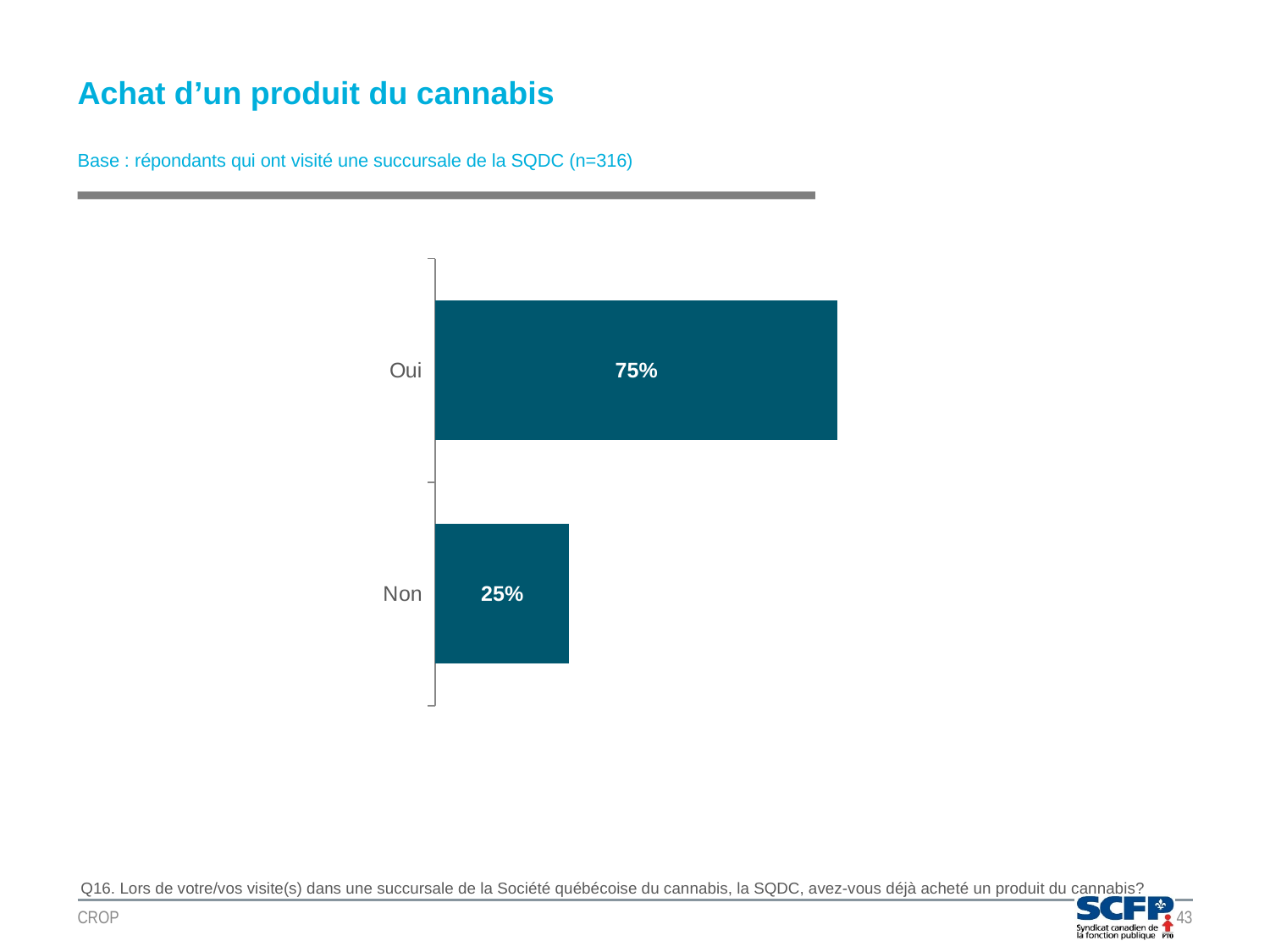
Which category has the lowest value? Non What is the difference between the values for Oui and Non? 50% What kind of chart is shown on the slide? Bar chart What is the title of the slide? Achat d’un produit du cannabis What is the total of the values for Oui and Non? 100% Which is larger, the value for Oui or the value for Non? Oui Which category has the highest value? Oui What is the value for Non? 25% What is the value for Oui? 75% How many categories are shown in the chart? 2 What is the sample size (n) stated in the base line of the slide? 316